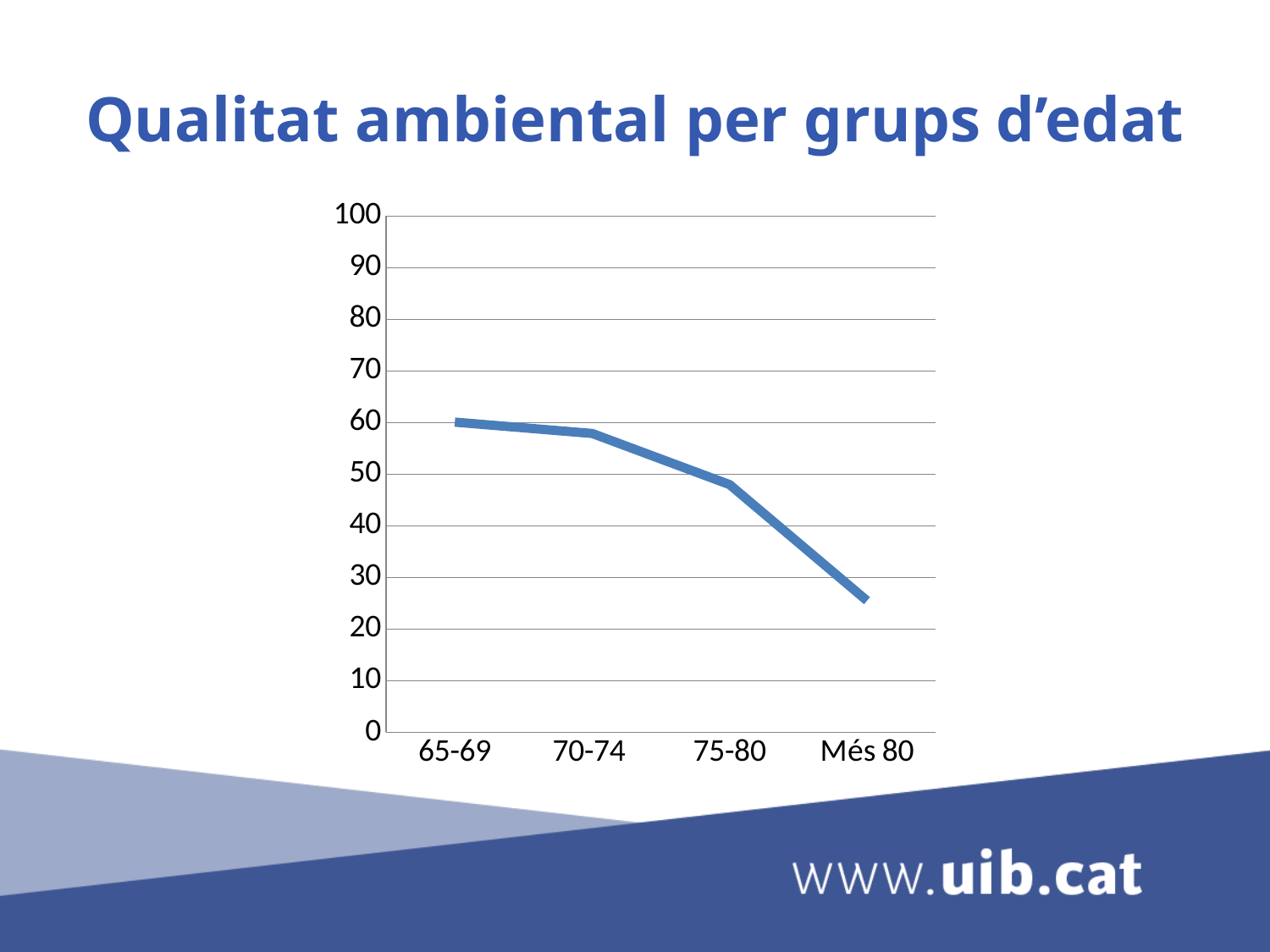
Which age group has the lowest value? Més 80 How many age groups are plotted on the x axis? 4 Is the value for 65-69 greater or less than 50? greater Is the value for Més 80 greater or less than 30? less What is the title of the chart? Qualitat ambiental per grups d’edat Is the value for 70-74 greater or less than 50? greater What kind of chart is shown on the slide? line chart Which has the larger value, 65-69 or Més 80? 65-69 Do the values rise or fall as the age groups increase along the x axis? fall Which has the larger value, 70-74 or 75-80? 70-74